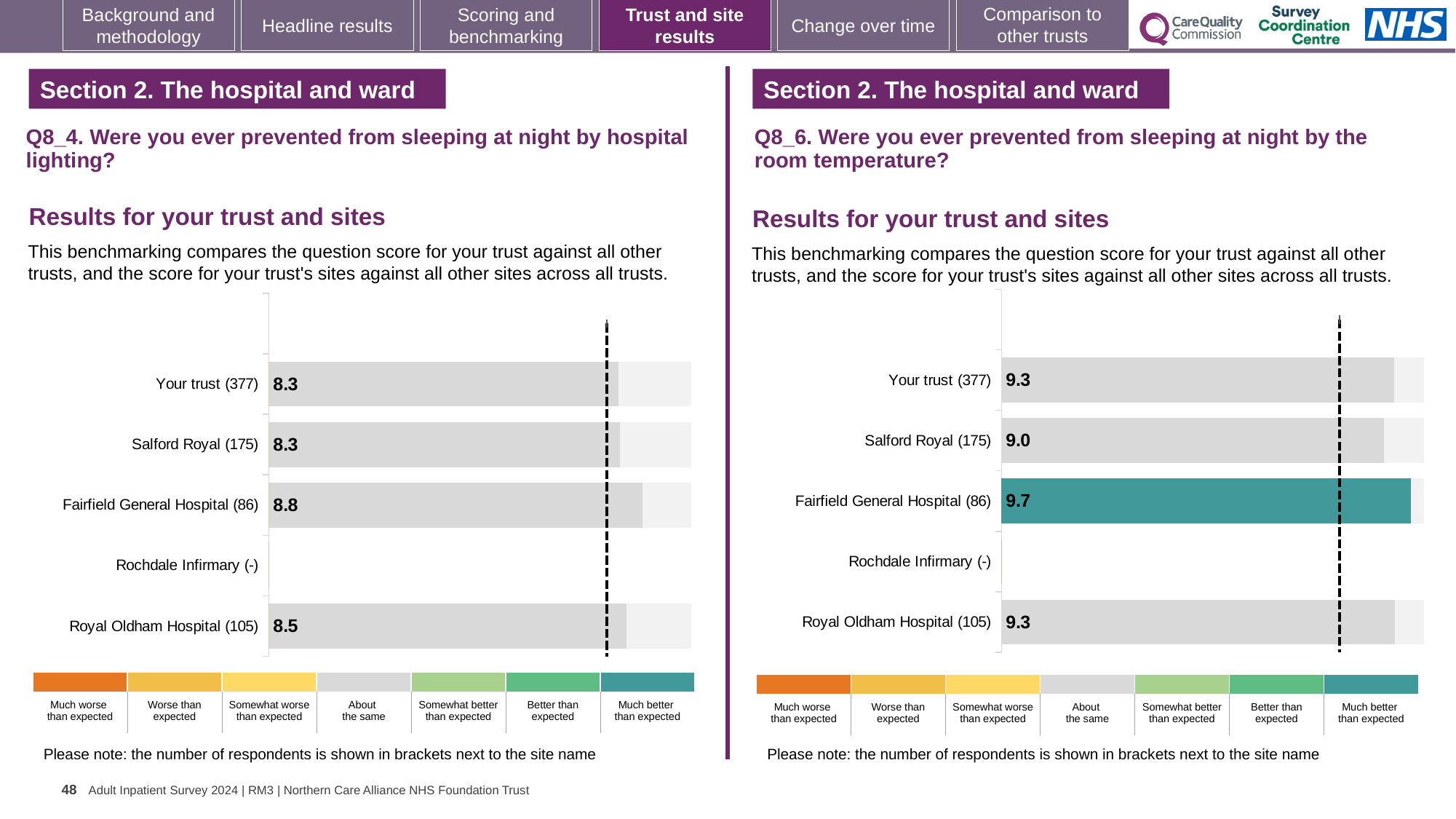
In the Q8_4 chart (hospital lighting), what is the score for Royal Oldham Hospital? 8.5 In the Q8_6 chart (room temperature), what is the score for Salford Royal? 9.0 How many sites (rows) are listed in the Q8_6 chart (room temperature)? 5 In the Q8_6 chart (room temperature), what is the score for Fairfield General Hospital? 9.7 In the Q8_6 chart (room temperature), what is the difference between the scores for Fairfield General Hospital and Royal Oldham Hospital? 0.4 In the Q8_6 chart (room temperature), which benchmark category does the colour of the Fairfield General Hospital bar indicate? Much better than expected In the Q8_4 chart (hospital lighting), what is the difference between the scores for Fairfield General Hospital and Salford Royal? 0.5 In the Q8_4 chart (hospital lighting), how many respondents are shown for Your trust? 377 In the Q8_6 chart (room temperature), is the score for Your trust larger or smaller than the score for Salford Royal? larger In the Q8_4 chart (hospital lighting), what is the score for Fairfield General Hospital? 8.8 In the Q8_6 chart (room temperature), which site has the lowest score among those with a score shown? Salford Royal In the Q8_4 chart (hospital lighting), which site has the highest score? Fairfield General Hospital